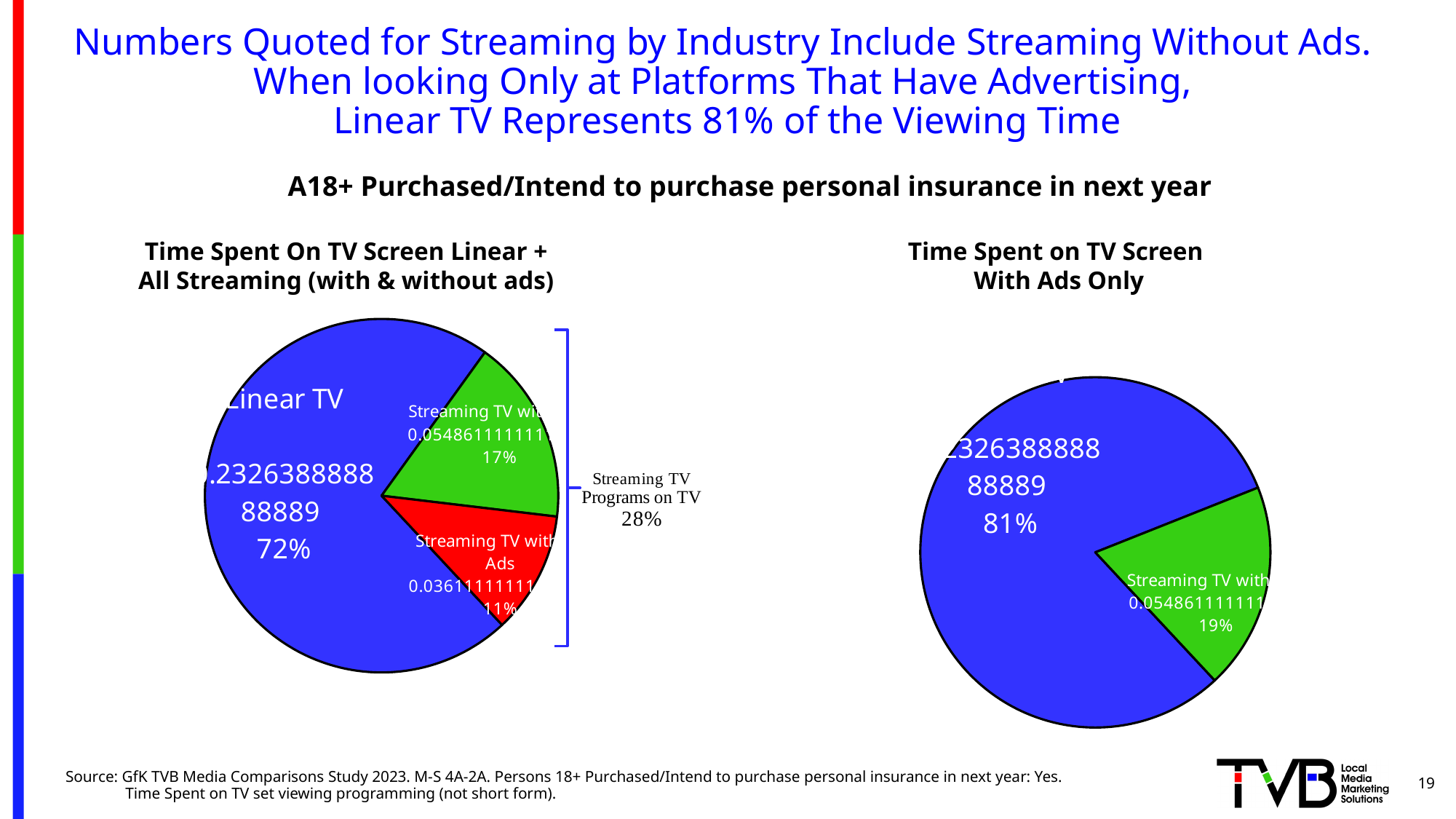
In the left pie chart (Linear + All Streaming), how many slices are there? 3 In the left pie chart (Linear + All Streaming), which is larger: the green slice or the red slice? The green slice In the right pie chart (With Ads Only), what percentage is shown on the green slice? 19% What type of chart is used on this slide? Pie chart In the left pie chart (Linear + All Streaming), what percentage is shown on the green slice? 17% In the left pie chart (Linear + All Streaming), which slice is the largest? Linear TV In the left pie chart (Linear + All Streaming), what share of viewing time does Linear TV represent? 72% In the left pie chart (Linear + All Streaming), what combined share is labelled for Streaming TV Programs on TV by the bracket? 28%